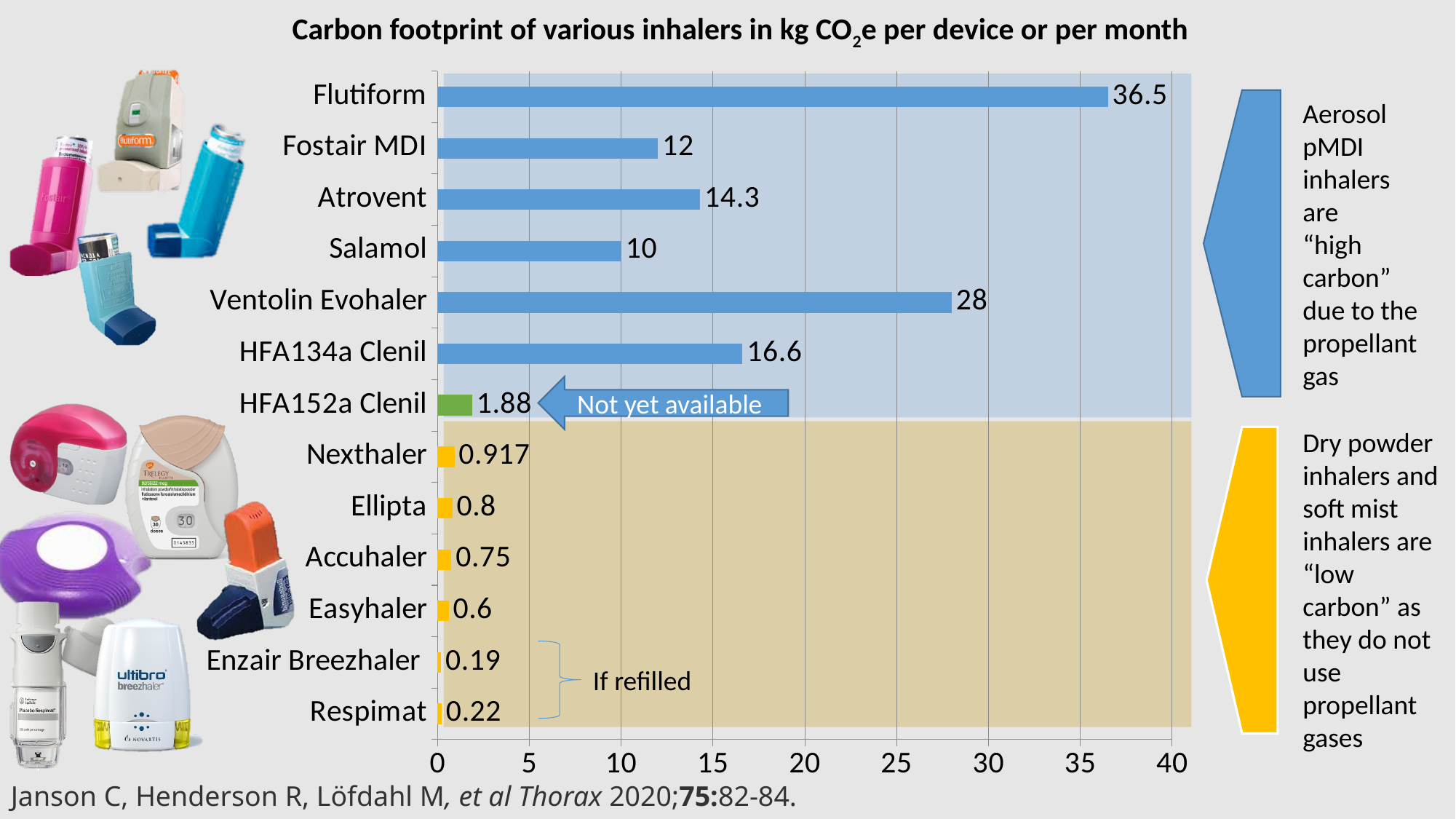
What is the difference between the values for HFA134a Clenil and HFA152a Clenil? 14.72 What is the value shown for Nexthaler? 0.917 Which has a larger carbon footprint, Atrovent or Fostair MDI? Atrovent What is the carbon footprint value shown for Ventolin Evohaler? 28 What is the difference between the values for Flutiform and Ventolin Evohaler? 8.5 What type of chart is shown on the slide? Bar chart What is the value shown for HFA152a Clenil? 1.88 What is the title of the chart? Carbon footprint of various inhalers in kg CO2e per device or per month What is the carbon footprint value shown for Flutiform? 36.5 Which inhaler has the highest carbon footprint on the chart? Flutiform Which inhaler has the lowest carbon footprint on the chart? Enzair Breezhaler How many inhalers are listed on the chart? 13